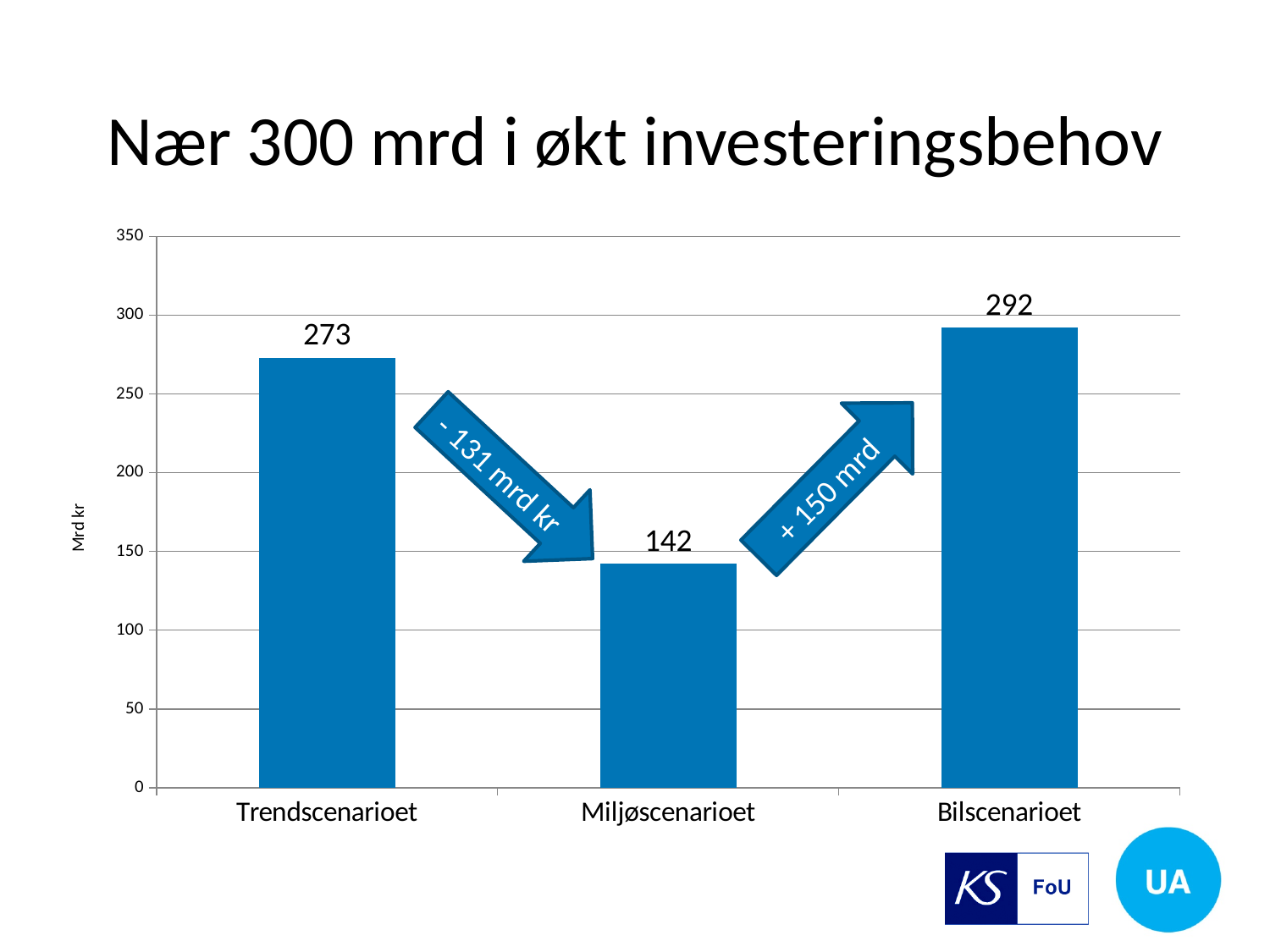
What is the value for Bilscenarioet? 292 What kind of chart is shown on the slide? bar chart What is the value for Trendscenarioet? 273 Which category has the lowest value? Miljøscenarioet How many categories are shown on the x axis? 3 What is the label on the vertical axis? Mrd kr What is the value for Miljøscenarioet? 142 What is the difference between the values for Trendscenarioet and Miljøscenarioet? 131 What is the difference between the values for Bilscenarioet and Miljøscenarioet? 150 Which category has the highest value? Bilscenarioet Is the value for Miljøscenarioet greater or less than 150? less Which is larger, the value for Trendscenarioet or the value for Bilscenarioet? Bilscenarioet